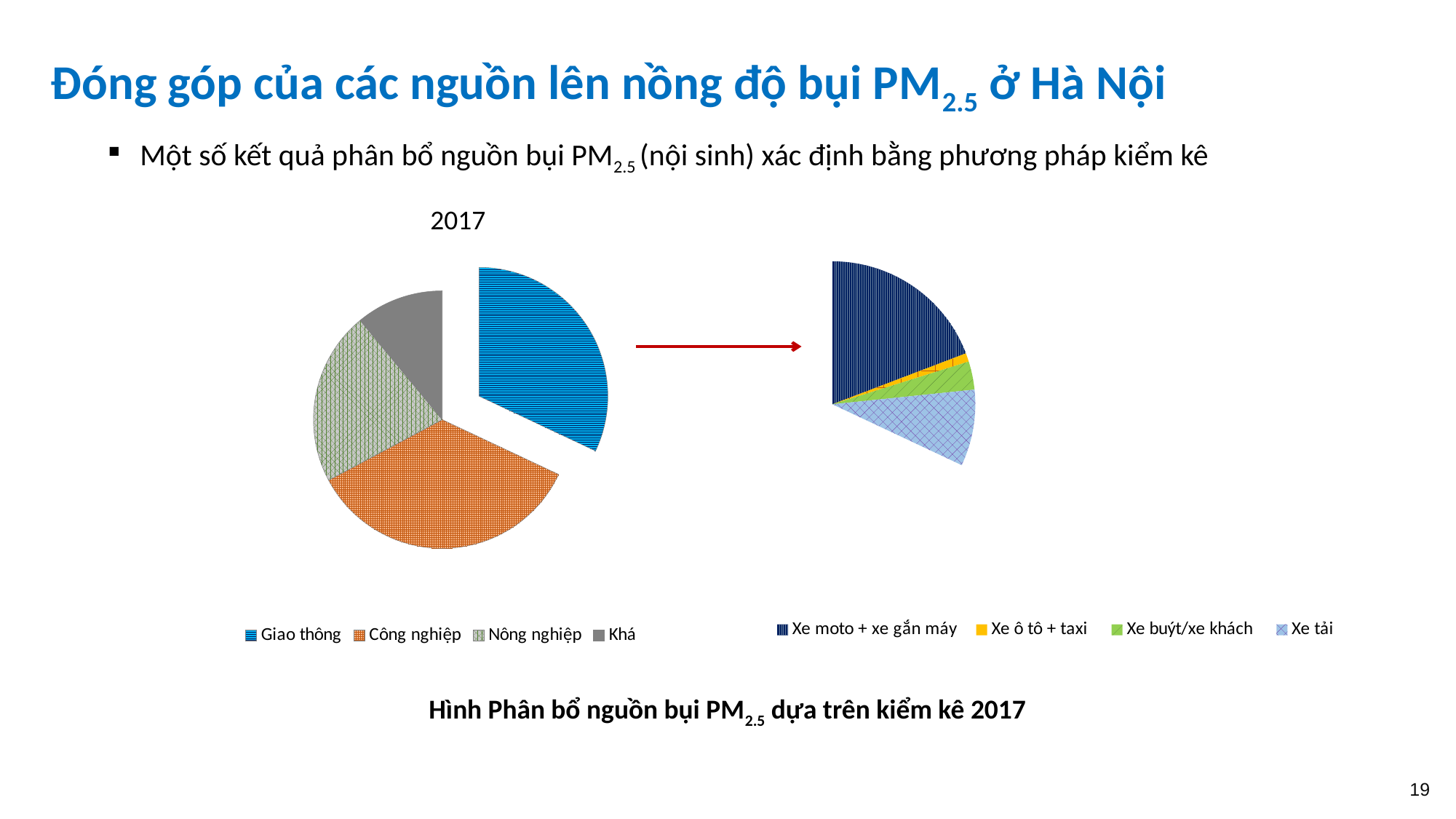
In the left pie chart titled "2017", which slice is larger: Giao thông or Khá? Giao thông What is the title shown above the left pie chart? 2017 How many categories does the legend of the left pie chart titled "2017" list? 4 In the left pie chart titled "2017", which category is shown in orange? Công nghiệp In the right-hand breakdown chart, which category has the largest slice? Xe moto + xe gắn máy What kind of chart is the chart titled "2017" on the left of the slide? pie chart In the left pie chart titled "2017", which category has the smallest slice? Khá In the right-hand breakdown chart, which slice is larger: Xe tải or Xe buýt/xe khách? Xe tải In the left pie chart titled "2017", which slice is larger: Nông nghiệp or Khá? Nông nghiệp In the right-hand breakdown chart, which category has the smallest slice? Xe ô tô + taxi How many entries does the legend of the right-hand breakdown chart list? 4